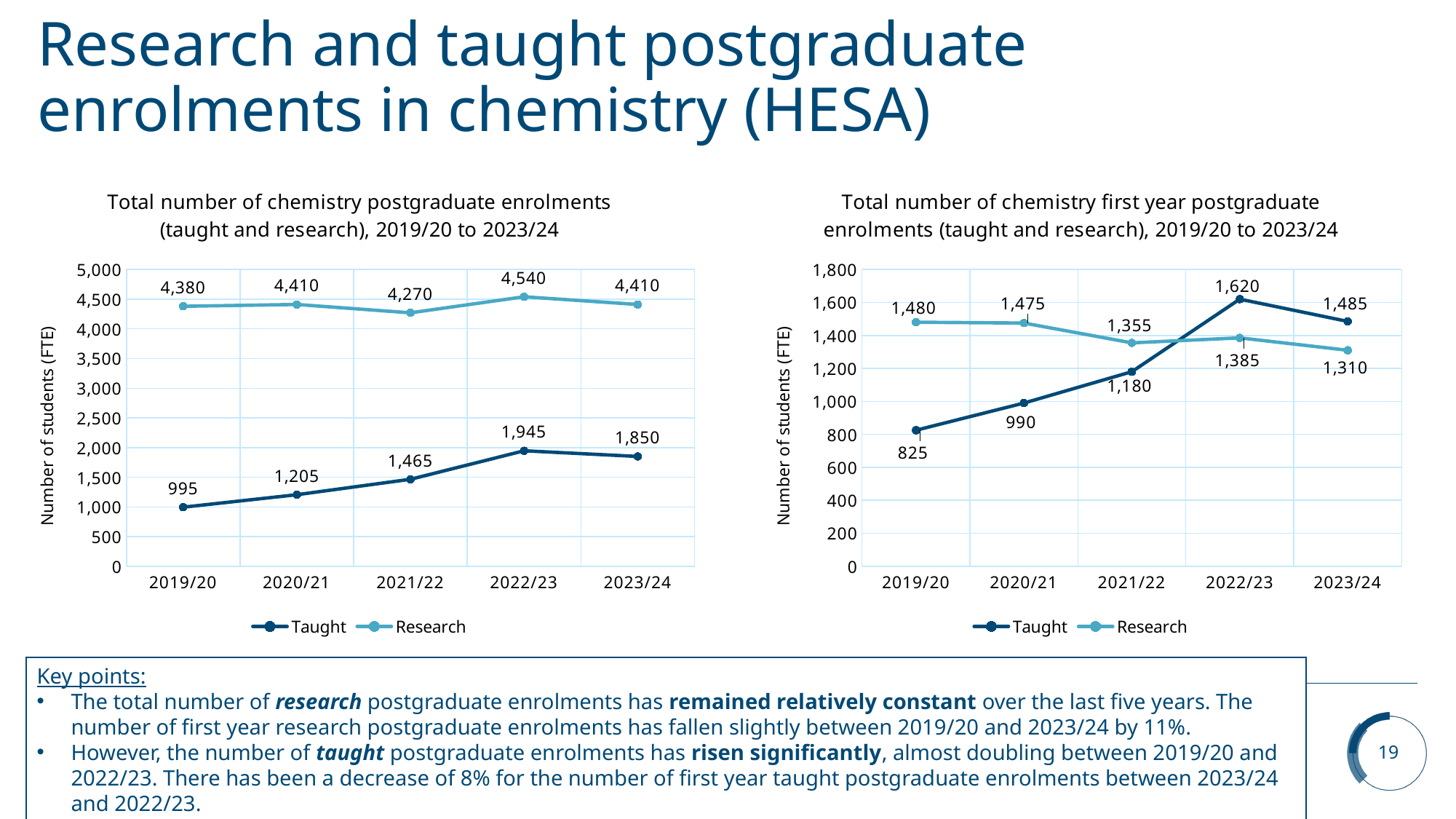
In the left chart (Total number of chemistry postgraduate enrolments), what is the Taught value for 2019/20? 995 In the right chart, which is larger in 2021/22, the Taught value or the Research value? Research How many series does the legend of the right chart list? 2 In the left chart, which year has the highest Taught value? 2022/23 In the left chart, which year has the lowest Research value? 2021/22 In the right chart (first year postgraduate enrolments), what is the Research value for 2023/24? 1,310 In the right chart, what is the difference between the Taught and Research values in 2023/24? 175 In the right chart (first year postgraduate enrolments), what is the Taught value for 2022/23? 1,620 In the left chart, what is the difference between the Taught values for 2022/23 and 2019/20? 950 In the right chart, does the Research series rise or fall from 2019/20 to 2023/24? Fall In the left chart (Total number of chemistry postgraduate enrolments), what is the Research value for 2022/23? 4,540 What kind of chart is the left chart? Line chart